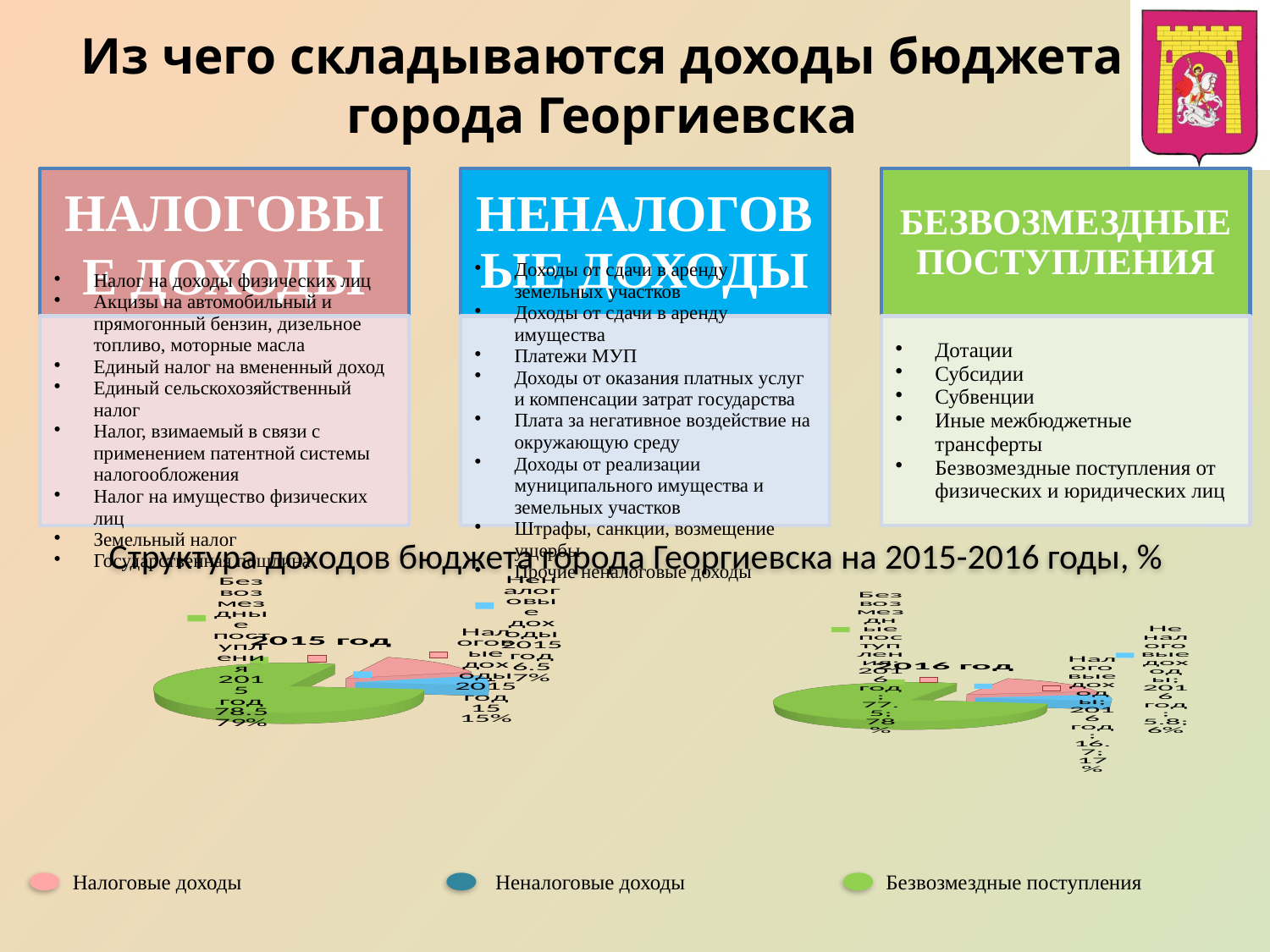
In the 2016 год pie chart, what percentage share is shown for Налоговые доходы? 17% In the 2016 год pie chart, which category has the largest slice? Безвозмездные поступления In the 2016 год pie chart, what percentage share is shown for Неналоговые доходы? 6% How many slices does each pie chart have? 3 Which colour represents Безвозмездные поступления in the legend at the bottom of the slide? Green In the 2015 год pie chart, what percentage share is shown for Безвозмездные поступления? 79% What kind of charts are shown at the bottom of the slide? Pie charts In the 2016 год pie chart, what value is printed for Безвозмездные поступления? 77.5 In the 2016 год pie chart, what percentage share is shown for Безвозмездные поступления? 78% How many pie charts are on the slide? 2 In the 2016 год pie chart, which category has the smallest slice? Неналоговые доходы In the 2015 год pie chart, what value is printed for Безвозмездные поступления? 78.5